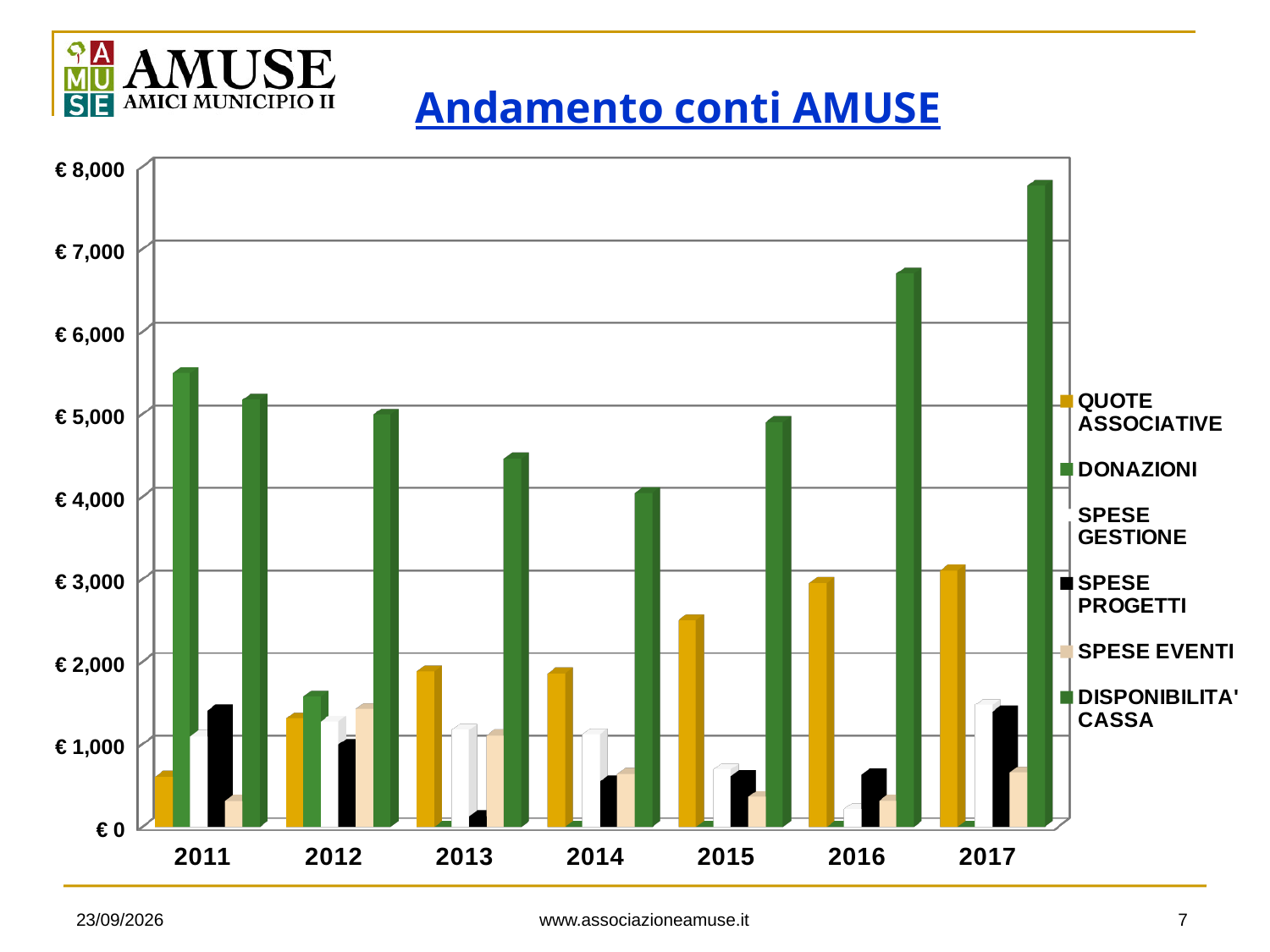
Is the value for DISPONIBILITA' CASSA in 2017 greater or less than € 7,000? greater How many series does the legend list? 6 What is the title of the chart? Andamento conti AMUSE Is the value for DISPONIBILITA' CASSA in 2014 greater or less than € 5,000? less In which year is QUOTE ASSOCIATIVE lowest? 2011 In which year is DISPONIBILITA' CASSA lowest? 2014 Is the value for QUOTE ASSOCIATIVE in 2015 greater or less than € 2,000? greater In which year is DISPONIBILITA' CASSA highest? 2017 Do the QUOTE ASSOCIATIVE values generally rise or fall from 2011 to 2017? rise Which is larger, DONAZIONI in 2011 or DONAZIONI in 2012? 2011 What kind of chart is shown on the slide? Bar chart How many years are shown on the x axis? 7